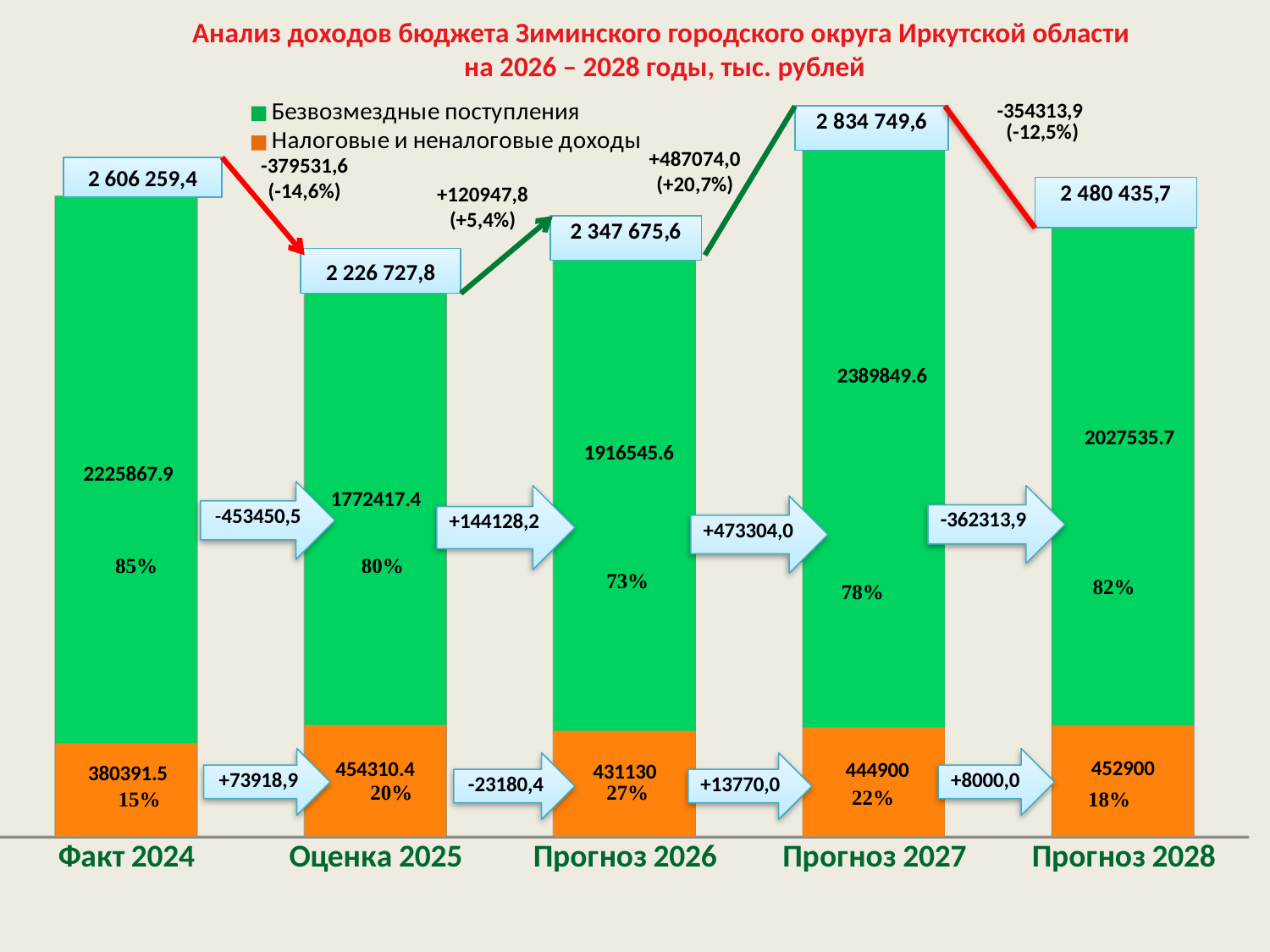
Which colour represents Налоговые и неналоговые доходы in the legend? orange Which category has the lowest total bar? Оценка 2025 How many categories are shown along the x axis? 5 What is the value of Безвозмездные поступления for Факт 2024? 2225867.9 What type of chart is shown on the slide? stacked bar chart What is the difference between Безвозмездные поступления for Прогноз 2027 and for Прогноз 2028? 362313.9 Which category has the highest total bar? Прогноз 2027 What is the total of the stacked bar for Прогноз 2027? 2 834 749,6 How many series does the legend list? 2 What share of the Прогноз 2026 bar is Безвозмездные поступления? 73% What is the value of Налоговые и неналоговые доходы for Прогноз 2026? 431130 Which is larger: Налоговые и неналоговые доходы for Оценка 2025 or for Прогноз 2028? Оценка 2025